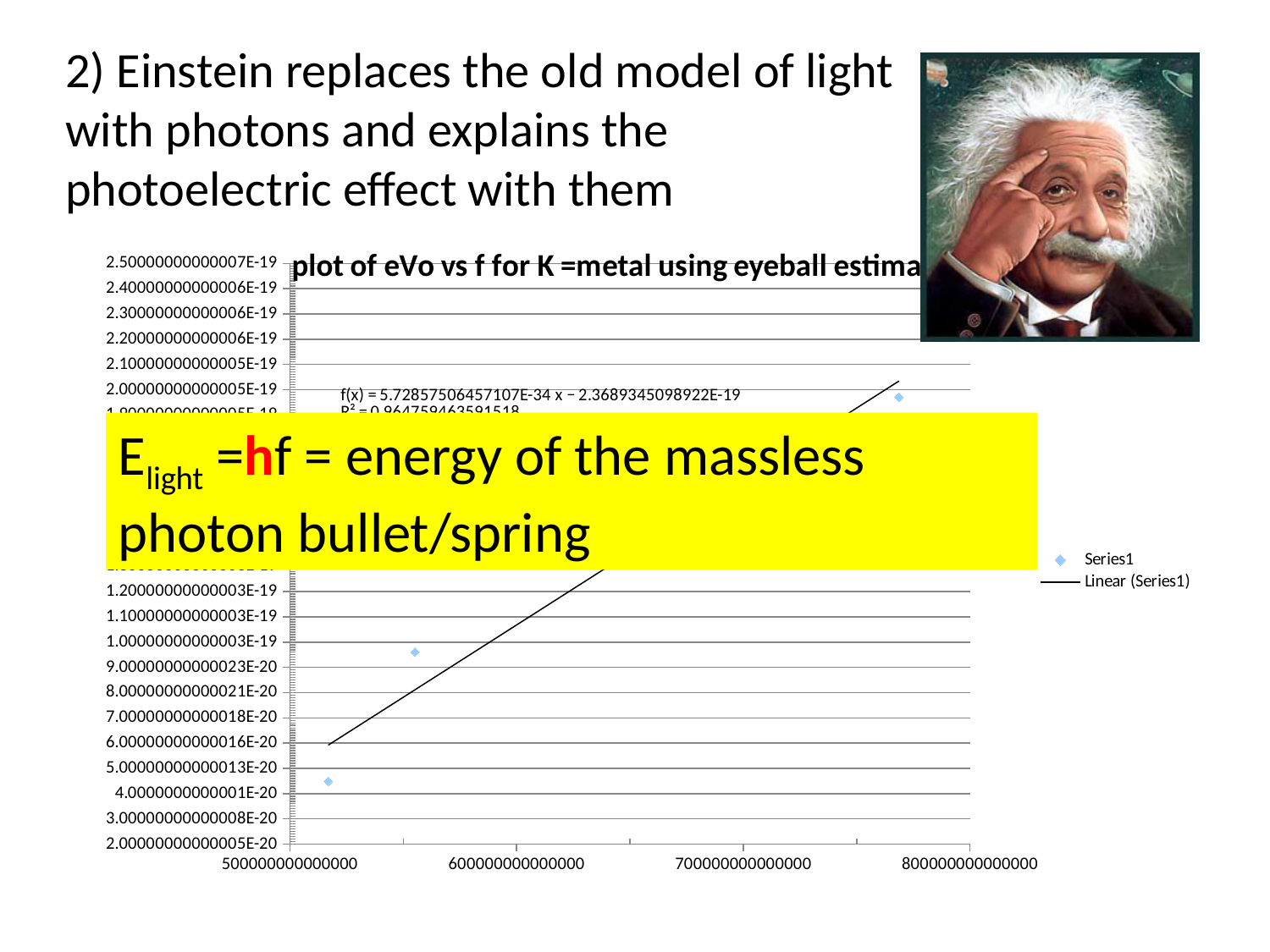
Is the value of the data point near x = 500000000000000 greater or less than 6.00000000000016E-20? less Is the value of the rightmost data point (near x = 780000000000000) greater or less than 1.20000000000003E-19? greater What is the highest value labelled on the x axis? 800000000000000 What kind of chart is shown on the slide? scatter chart How many entries does the chart legend list? 2 What is the slope (coefficient of x) in the trendline equation printed on the chart? 5.72857506457107E-34 Do the plotted values rise or fall as frequency increases along the x axis? rise Which has the larger eVo value: the data point near x = 550000000000000 or the data point near x = 500000000000000? the point near x = 550000000000000 Is the lowest plotted data point at the left end or the right end of the x axis? left end What is the lowest value labelled on the y axis? 2.00000000000005E-20 What are the two entries in the chart legend? Series1 and Linear (Series1) Is the highest plotted data point at the left end or the right end of the x axis? right end